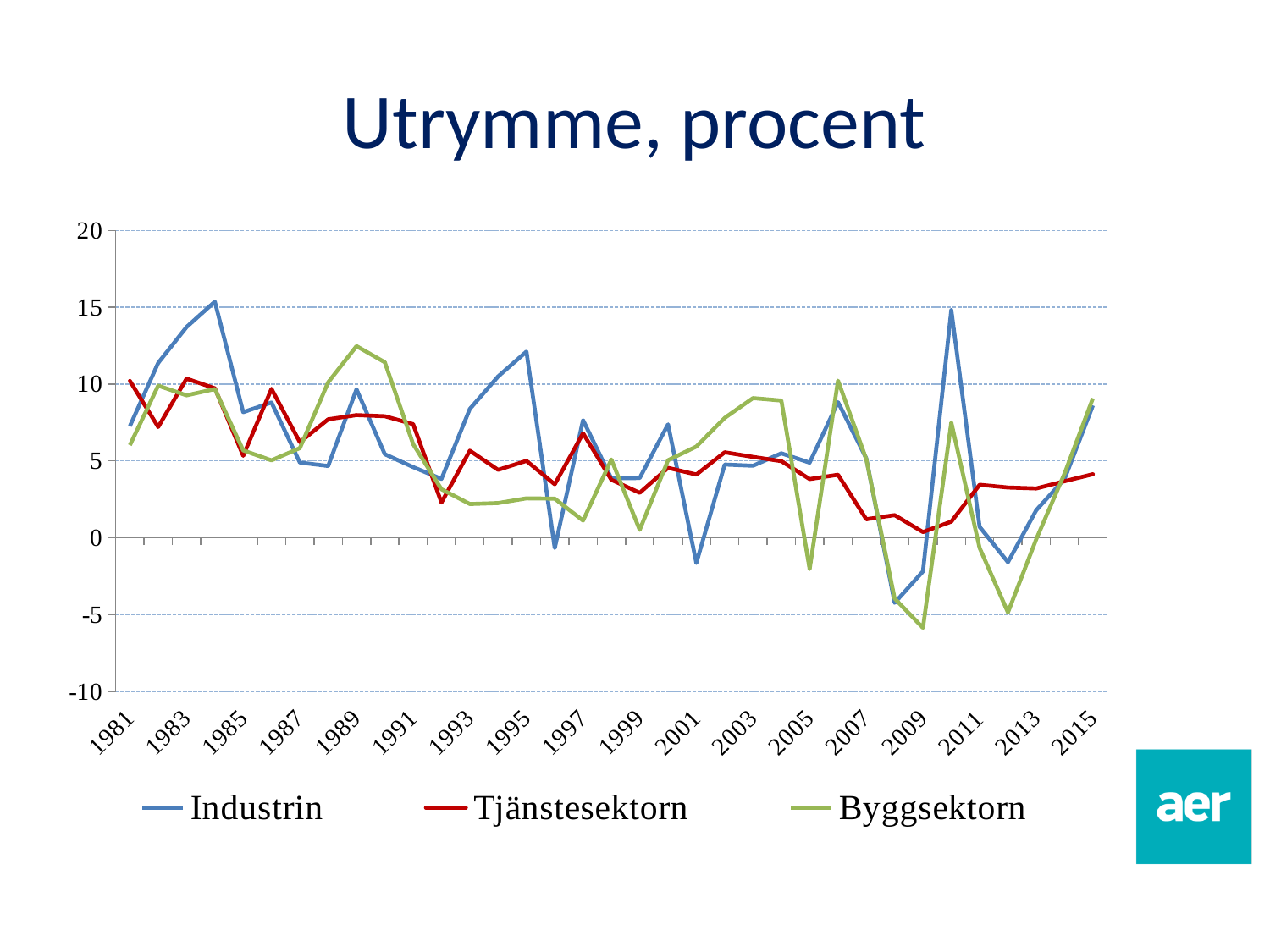
Is the value for Byggsektorn in 1989 greater or less than 10? greater What is the title of the chart? Utrymme, procent Is the value for Industrin in 2009 greater or less than 0? less Is the value for Industrin in 1984 greater or less than 10? greater What kind of chart is shown on the slide? line chart Does the Tjänstesektorn line generally rise or fall from 1981 to 2015? fall Which colour is used for the Byggsektorn line? green In 2010, which series has the higher value, Industrin or Byggsektorn? Industrin How many series does the legend list? 3 How many years are labeled on the x axis? 18 In 1989, which series has the higher value, Byggsektorn or Industrin? Byggsektorn